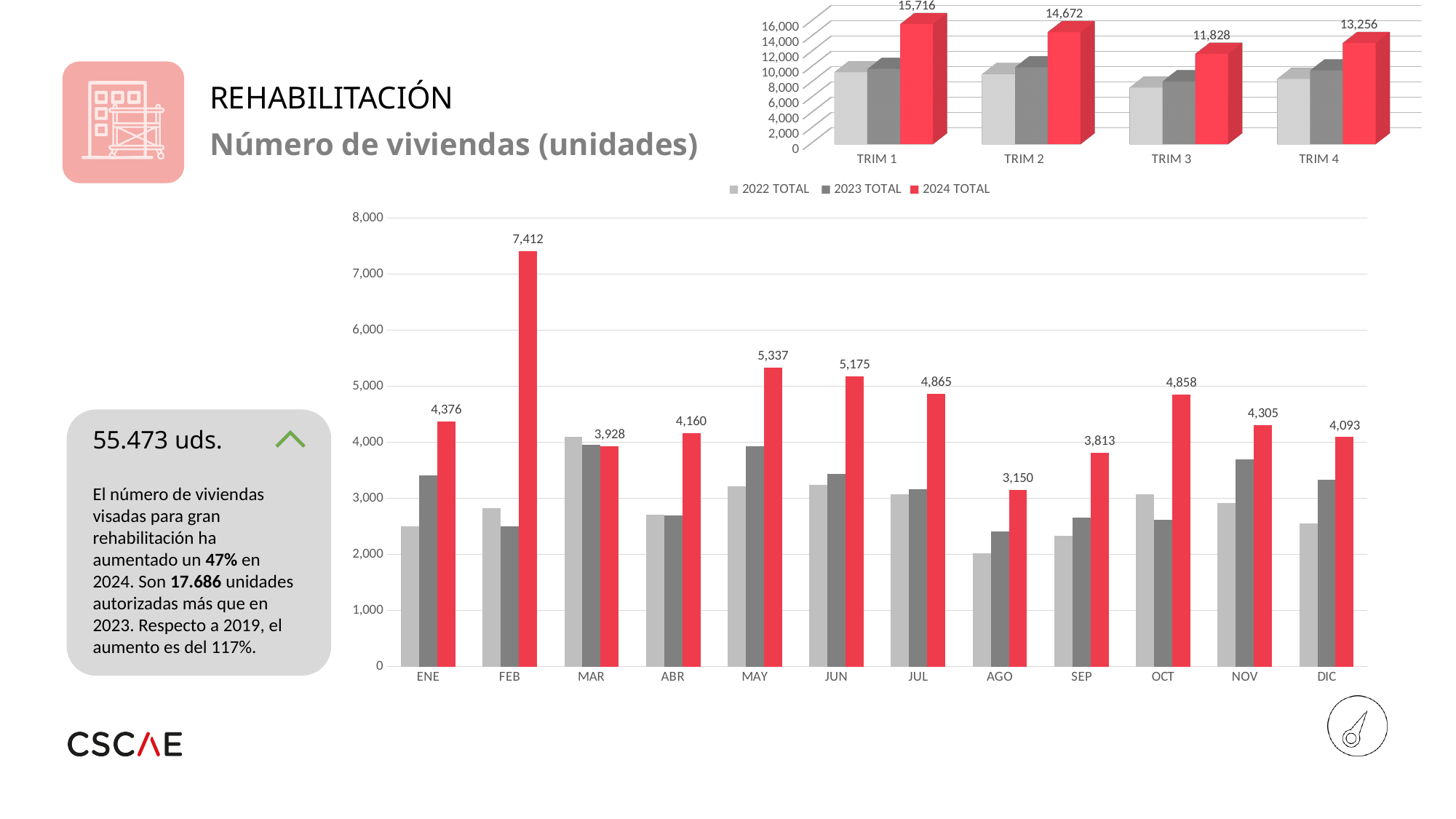
In the bottom monthly chart, what is the difference between the 2024 values for MAY and JUN? 162 In the top-right quarterly chart, which quarter has the lowest 2024 TOTAL value? TRIM 3 In the bottom monthly chart, which month has the lowest labelled 2024 value? AGO In the bottom monthly chart, what is the labelled 2024 value for FEB? 7,412 How many months are shown on the x axis of the bottom monthly chart? 12 In the top-right quarterly chart, what is the 2024 TOTAL value for TRIM 1? 15,716 In the top-right quarterly chart, what is the difference between the 2024 TOTAL values for TRIM 1 and TRIM 2? 1,044 In the bottom monthly chart, is the 2024 value for JUL or for OCT larger? JUL In the top-right quarterly chart, which quarter has the highest 2024 TOTAL value? TRIM 1 How many series does the legend list? 3 In the bottom monthly chart, which month has the highest labelled 2024 value? FEB In the bottom monthly chart, is the 2023 TOTAL (dark grey) value for NOV greater or less than 3,000? greater